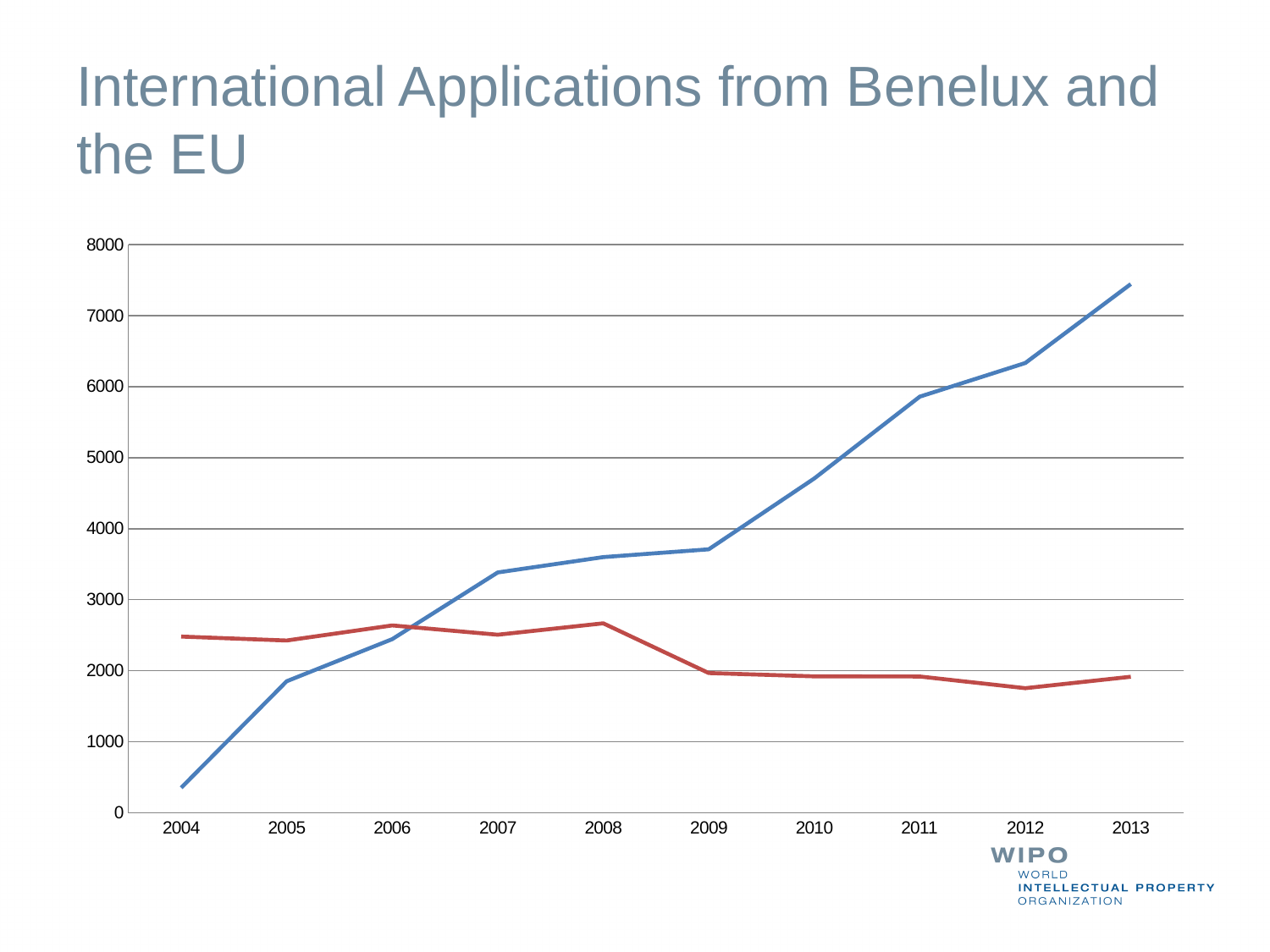
How many lines are plotted on the chart? 2 Is the value of the blue line in 2011 greater or less than 5000? greater In 2004, which line has the higher value, the blue line or the red line? the red line What kind of chart is shown on the slide? line chart Is the value of the blue line in 2004 greater or less than 1000? less What is the title of the chart on the slide? International Applications from Benelux and the EU Is the value of the blue line in 2013 greater or less than 7000? greater In 2013, which line has the higher value, the blue line or the red line? the blue line In which year does the blue line reach its highest value? 2013 Does the blue line generally rise or fall from 2004 to 2013? rise How many years are shown along the x axis of the chart? 10